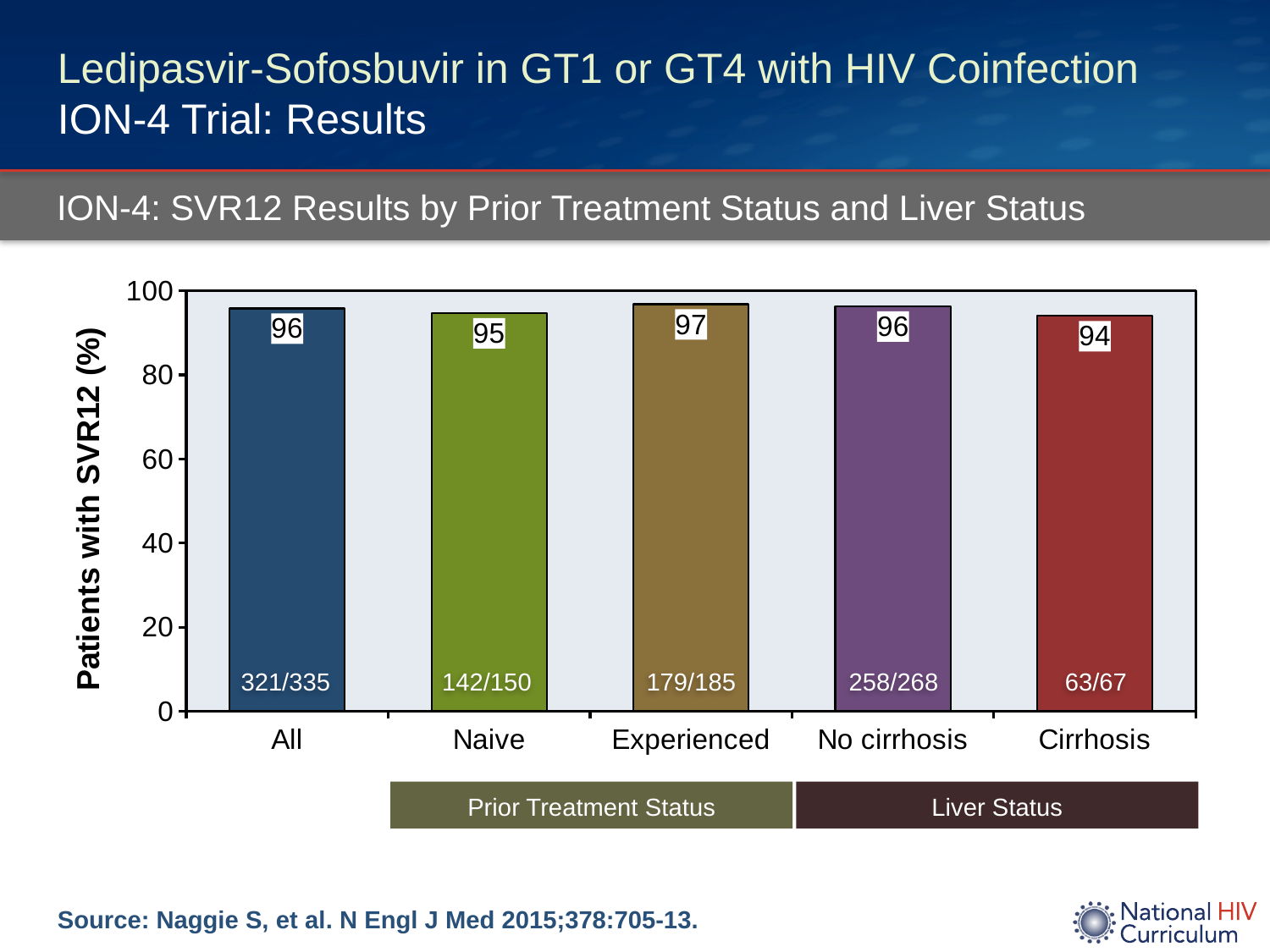
Which category has the highest SVR12 rate? Experienced What is the difference in SVR12 rate between the Experienced and Cirrhosis groups? 3 What fraction of patients is shown for the Cirrhosis group? 63/67 What is the SVR12 rate for the All group? 96 Which has a higher SVR12 rate, Naive or Experienced? Experienced Which category has the lowest SVR12 rate? Cirrhosis What kind of chart is shown? Bar chart What is the SVR12 rate for the Experienced group? 97 What is the SVR12 rate for the Cirrhosis group? 94 How many categories are shown on the x axis? 5 What is the label of the y axis? Patients with SVR12 (%) What fraction of patients is shown for the Naive group? 142/150